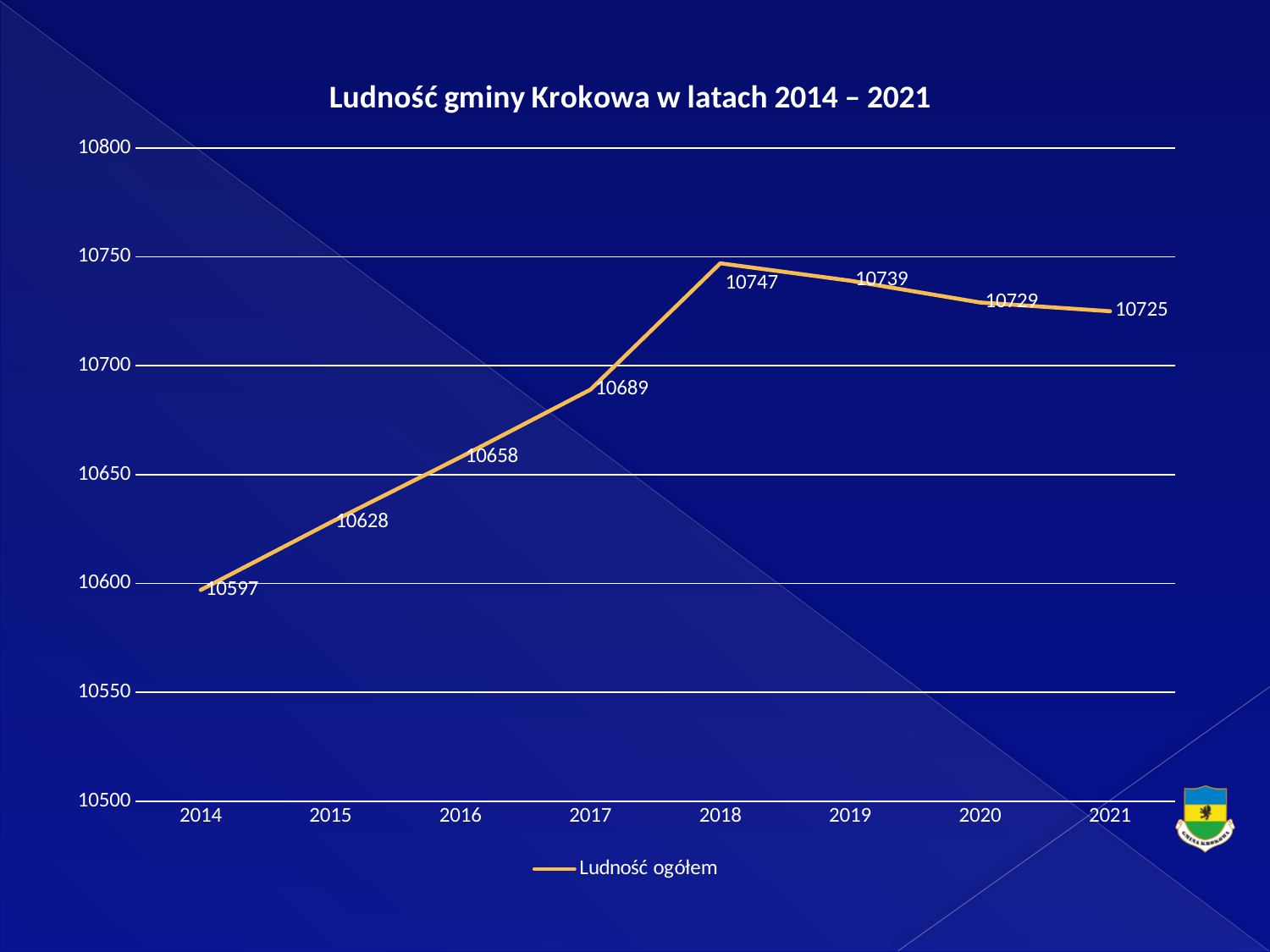
What is the difference between the 2017 and 2016 values? 31 Which year has the lowest population value? 2014 How many years are plotted on the x axis? 8 What was the population in 2021? 10725 What is the difference between the 2018 and 2014 values? 150 What kind of chart is shown on the slide? line chart Do the values rise or fall from 2014 to 2018? rise Is the value for 2017 greater or less than 10700? less Which is larger, the value for 2019 or the value for 2020? 2019 Which year has the highest population value? 2018 What was the population of Krokowa municipality in 2014? 10597 What value is shown for 2018? 10747